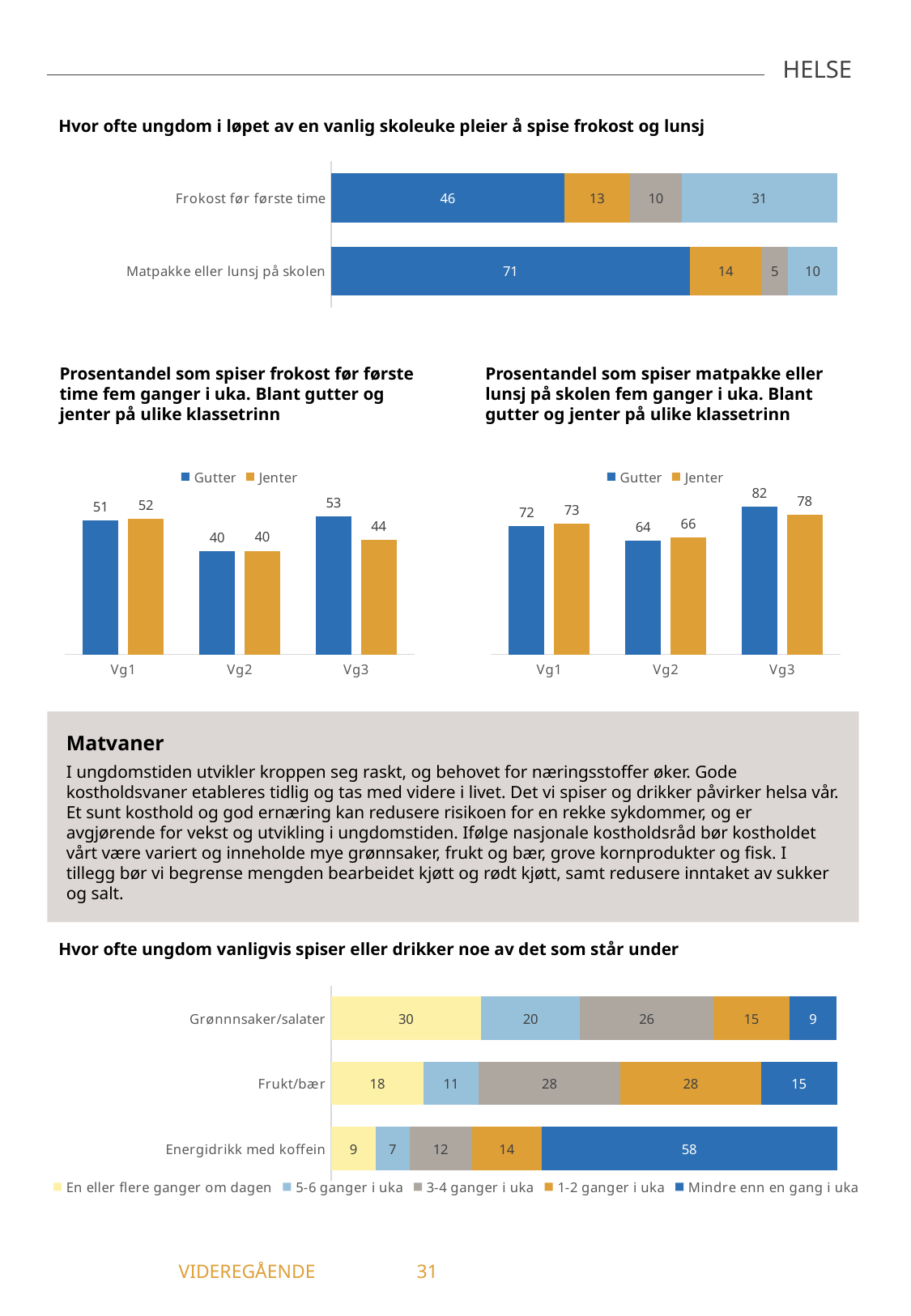
In the chart 'Hvor ofte ungdom vanligvis spiser eller drikker noe av det som står under', which is larger: 'En eller flere ganger om dagen' for 'Grønnnsaker/salater' or for 'Frukt/bær'? Grønnnsaker/salater What kind of chart is 'Hvor ofte ungdom i løpet av en vanlig skoleuke pleier å spise frokost og lunsj'? Stacked bar chart In the chart 'Hvor ofte ungdom i løpet av en vanlig skoleuke pleier å spise frokost og lunsj', what is the value of the first (leftmost) segment for 'Matpakke eller lunsj på skolen'? 71 In the chart 'Prosentandel som spiser matpakke eller lunsj på skolen fem ganger i uka', what is the value for Gutter at Vg3? 82 In the chart 'Hvor ofte ungdom vanligvis spiser eller drikker noe av det som står under', what is the value of 'Mindre enn en gang i uka' for 'Energidrikk med koffein'? 58 In the chart 'Prosentandel som spiser frokost før første time fem ganger i uka', which class level has the highest value for Gutter? Vg3 In the chart 'Prosentandel som spiser matpakke eller lunsj på skolen fem ganger i uka', which class level has the lowest value for Jenter? Vg2 How many series does the legend list in the chart 'Prosentandel som spiser matpakke eller lunsj på skolen fem ganger i uka'? 2 In the chart 'Prosentandel som spiser frokost før første time fem ganger i uka', what is the value for Jenter at Vg3? 44 In the chart 'Hvor ofte ungdom i løpet av en vanlig skoleuke pleier å spise frokost og lunsj', what is the total of the stacked bar for 'Frokost før første time'? 100 In the chart 'Hvor ofte ungdom vanligvis spiser eller drikker noe av det som står under', how many categories are shown? 3 In the chart 'Prosentandel som spiser frokost før første time fem ganger i uka', what is the difference between Gutter and Jenter at Vg3? 9